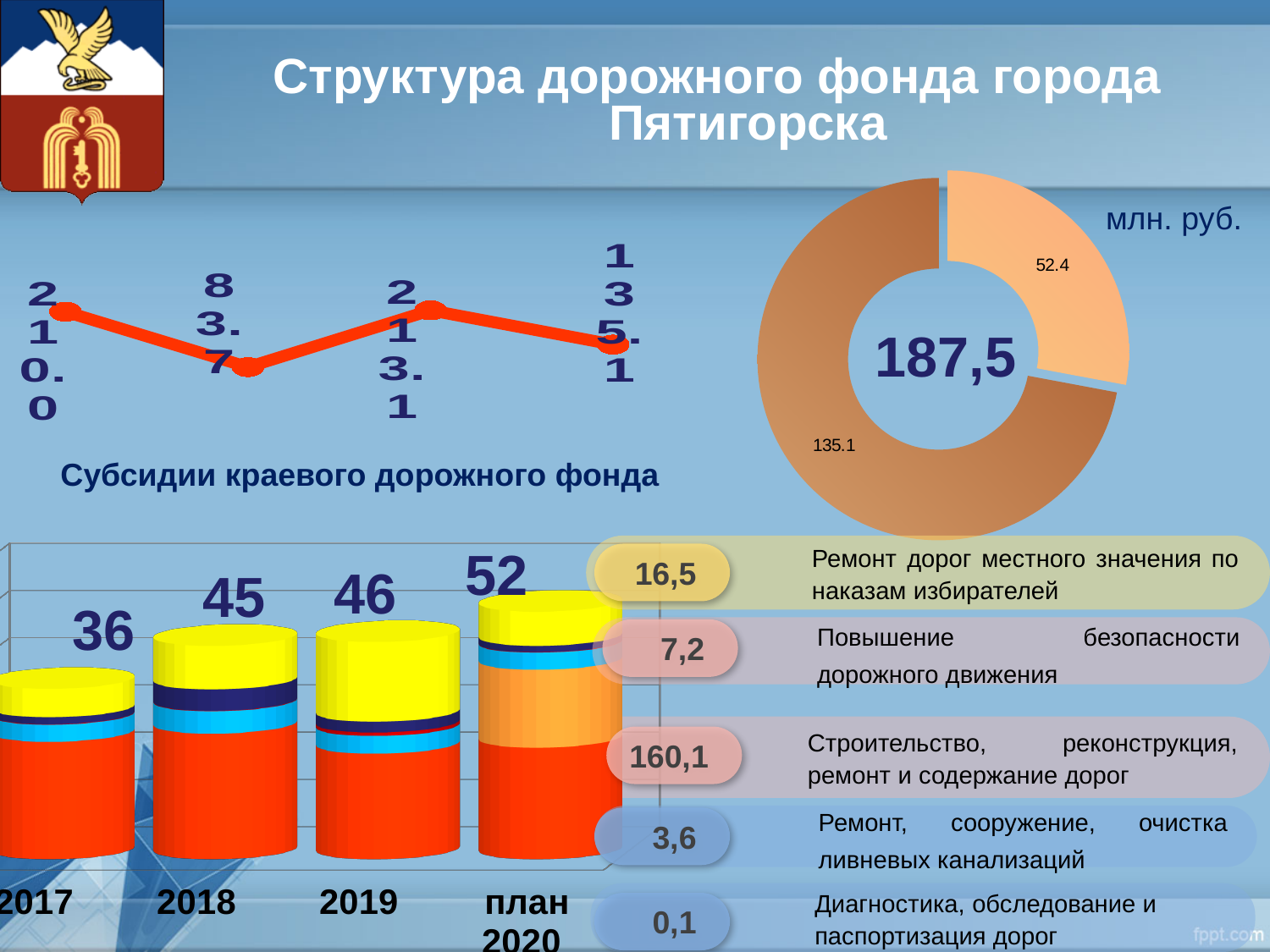
In the line chart 'Субсидии краевого дорожного фонда', what is the difference between the first point (210.0) and the second point (83.7)? 126.3 In the doughnut chart on the right, which slice is larger, 52.4 or 135.1? 135.1 What kind of chart is the one titled 'Субсидии краевого дорожного фонда'? line chart In the line chart 'Субсидии краевого дорожного фонда', how many data points are plotted? 4 In the line chart 'Субсидии краевого дорожного фонда', what is the lowest value shown? 83.7 In the bar chart at the bottom left, do the values rise or fall from 2017 to план 2020? rise In the bar chart at the bottom left, which year has the lowest value? 2017 In the line chart 'Субсидии краевого дорожного фонда', what is the highest value shown? 213.1 What number is shown in the centre of the doughnut chart on the right? 187,5 In the bar chart at the bottom left, which category has the highest value? план 2020 In the bar chart at the bottom left, what is the value for 2019? 46 In the bar chart at the bottom left, what is the difference between the values for план 2020 and 2017? 16